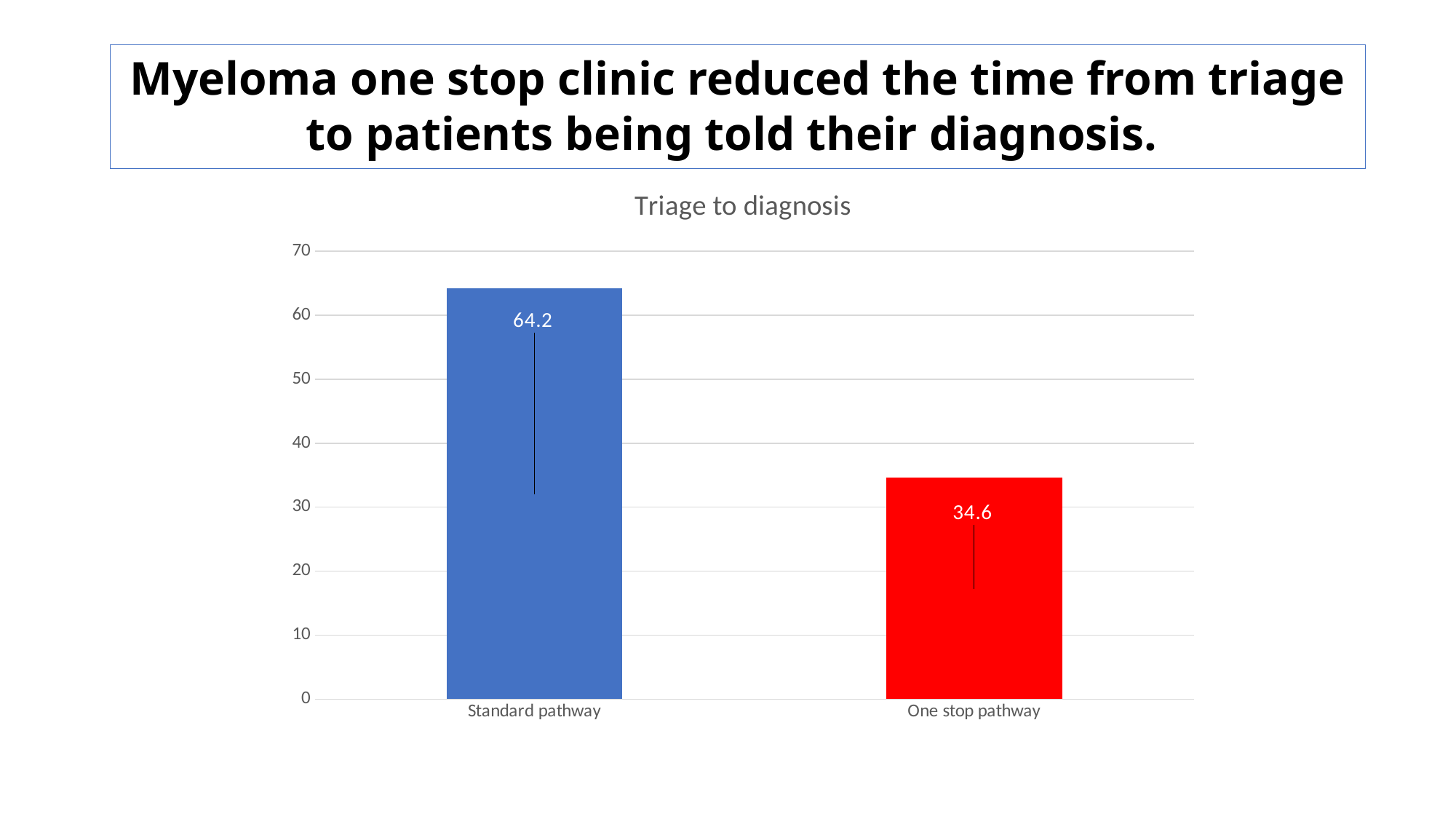
Which category has the highest value? Standard pathway How many categories are shown in the chart? 2 What is the value for One stop pathway? 34.6 Which category has the lowest value? One stop pathway What is the value for Standard pathway? 64.2 What is the difference between the Standard pathway and One stop pathway values? 29.6 What kind of chart is shown on the slide? bar chart What is the title of the chart? Triage to diagnosis Which is larger, the value for Standard pathway or the value for One stop pathway? Standard pathway What colour is the bar for One stop pathway? red Is the value for One stop pathway greater or less than 40? less Is the value for Standard pathway greater or less than 60? greater